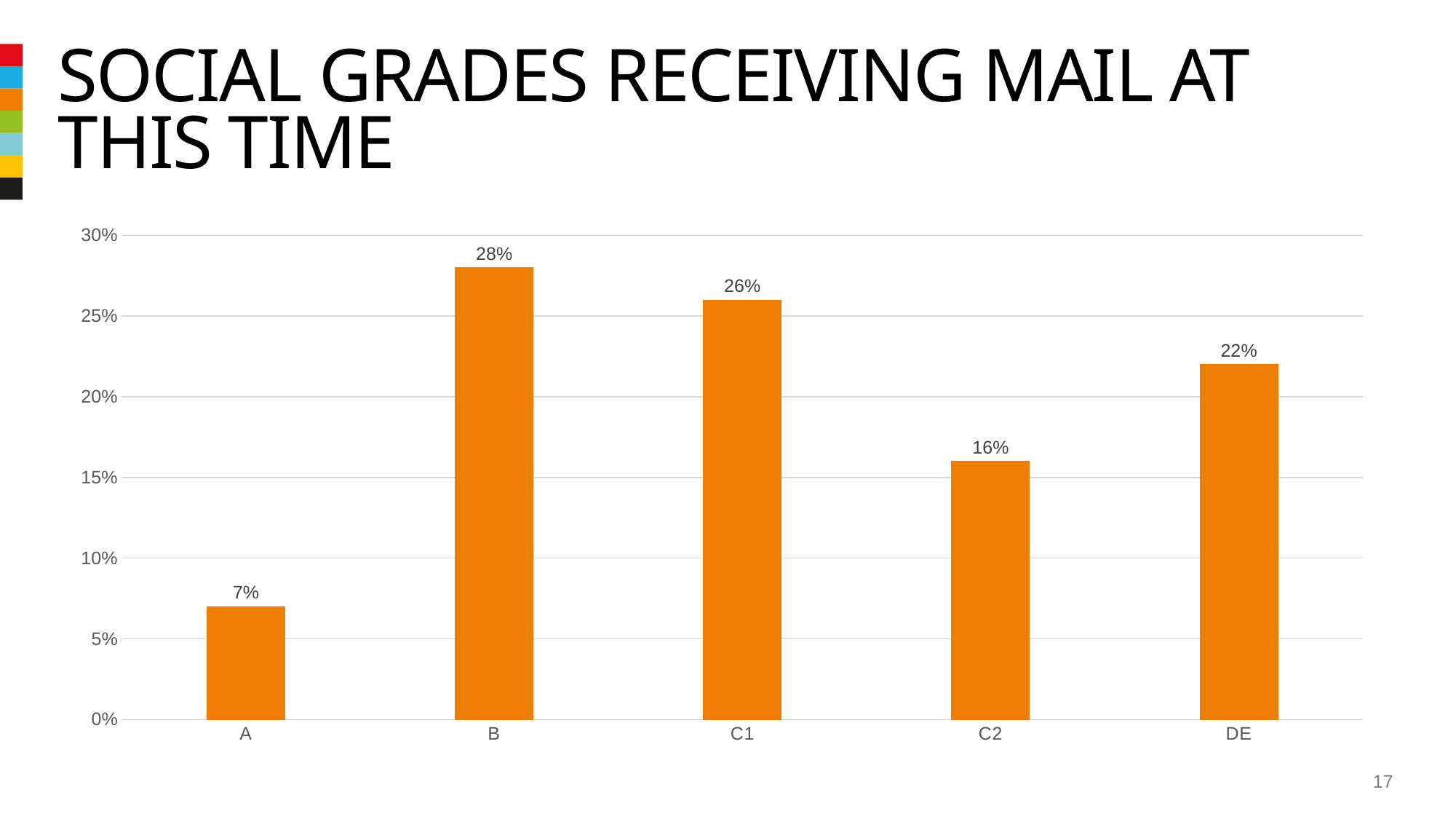
What is the value for social grade A? 7% What kind of chart is shown on the slide? Bar chart How many social grades are shown on the chart? 5 Is the value for C2 greater or less than 20%? less What is the difference between the values for B and C2? 12% What is the value for social grade DE? 22% Which social grade has the highest value? B Which social grade has the lowest value? A What is the difference between the values for C1 and DE? 4% What is the value for social grade B? 28% Which is larger, the value for C1 or the value for C2? C1 What is the title of the slide? Social grades receiving mail at this time